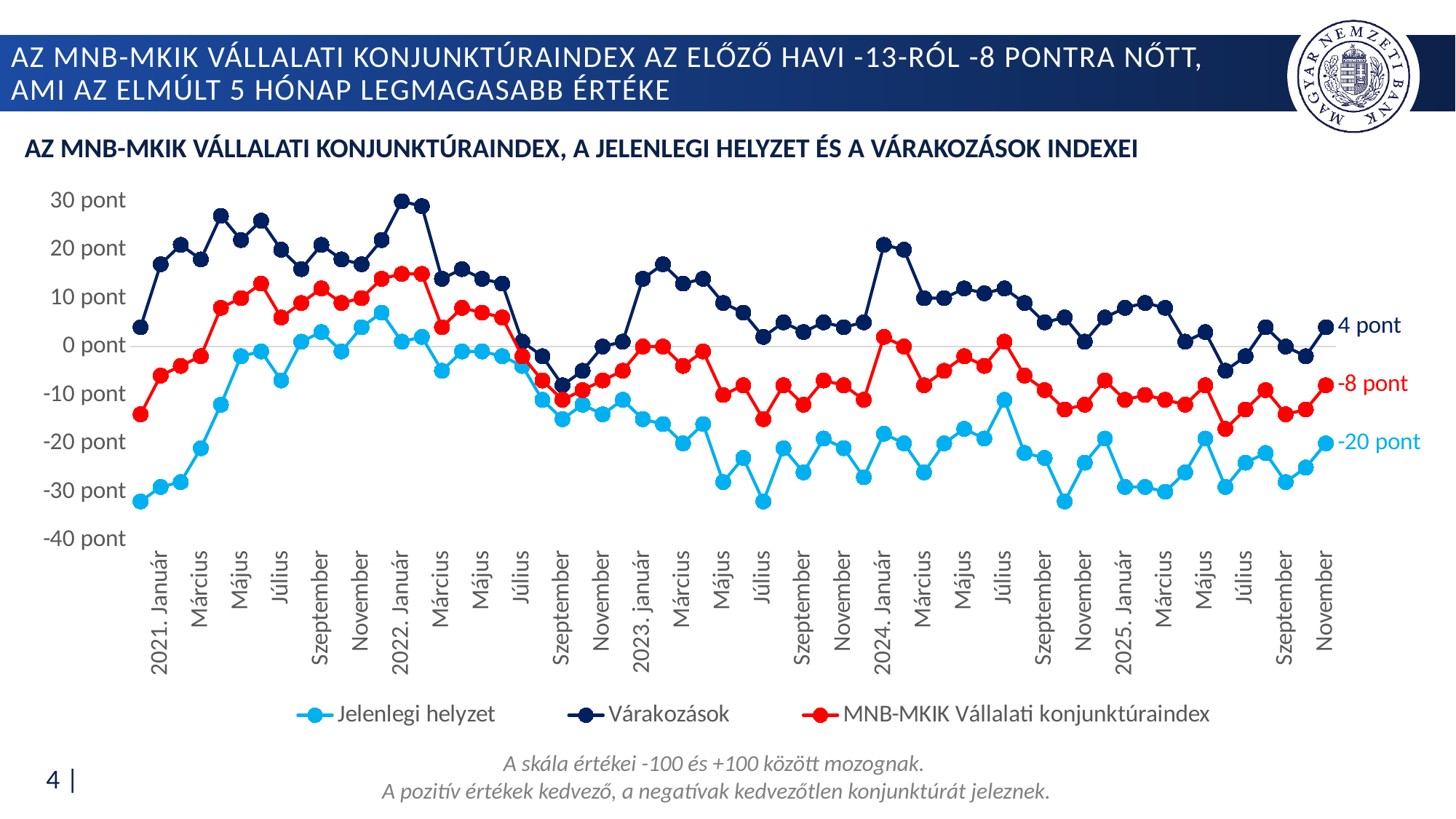
What kind of chart is shown on the slide? Line chart Which series has the highest value at the last point (2025 November)? Várakozások How many series does the legend list? 3 Is the value of the Várakozások series in 2022 January greater or less than 20 pont? greater What is the value of the Jelenlegi helyzet series at the last point (2025 November)? -20 pont What is the difference between the Várakozások value and the Jelenlegi helyzet value at the last point (2025 November)? 24 pont What is the value of the Várakozások series at the last point (2025 November)? 4 pont What is the value of the MNB-MKIK Vállalati konjunktúraindex series at the last point (2025 November)? -8 pont What is the difference between the Várakozások value and the MNB-MKIK Vállalati konjunktúraindex value at the last point (2025 November)? 12 pont At the last point (2025 November), which series has the higher value: Várakozások or Jelenlegi helyzet? Várakozások Does the Jelenlegi helyzet series rise or fall from 2021 January to 2021 May? Rise